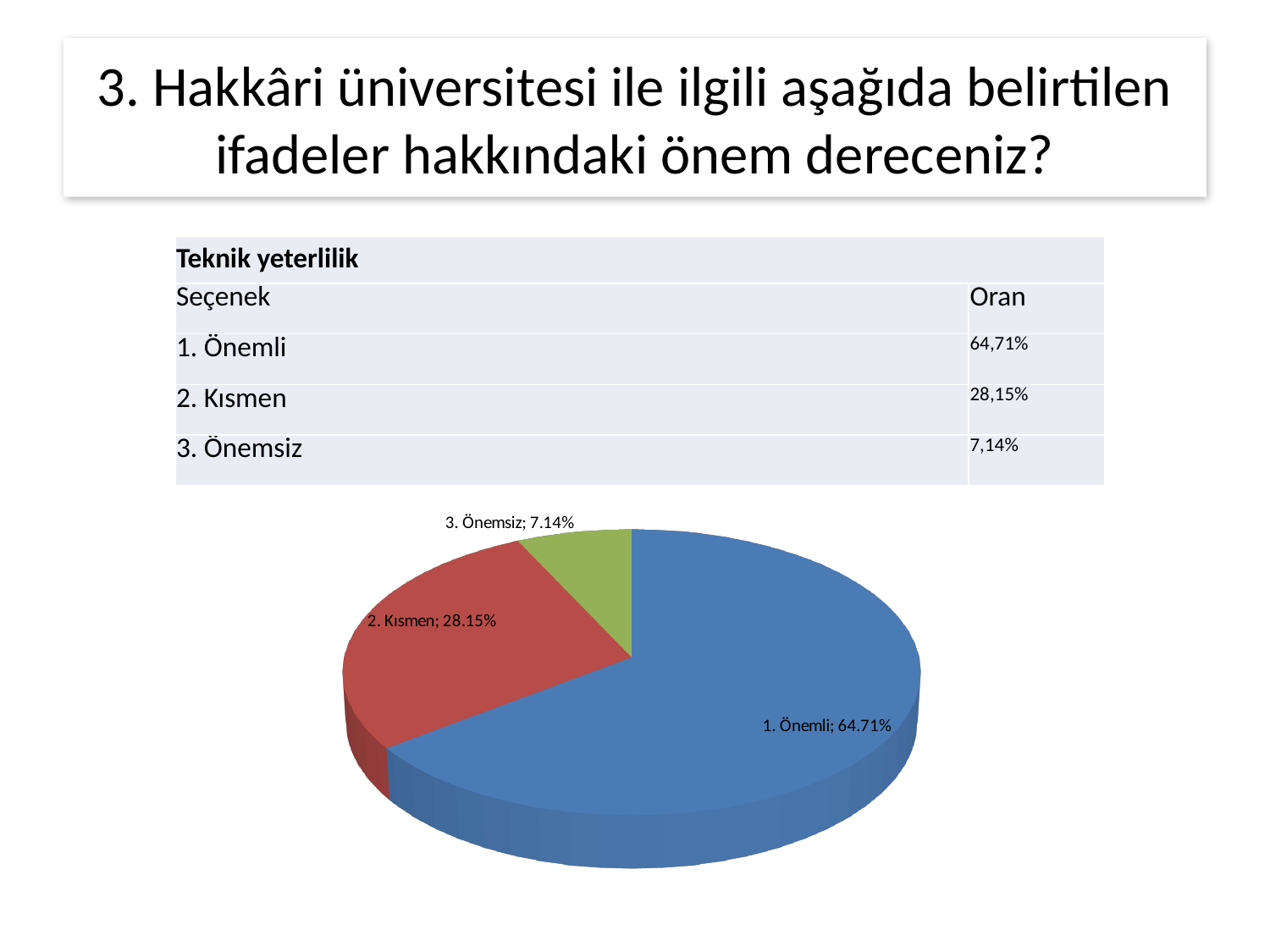
What is the value shown for the slice "1. Önemli" in the pie chart? 64.71% What is the value shown for the slice "3. Önemsiz" in the pie chart? 7.14% What kind of chart is shown on the slide? pie chart What is the difference between the values for "2. Kısmen" and "3. Önemsiz" in the pie chart? 21.01% What is the difference between the values for "1. Önemli" and "2. Kısmen" in the pie chart? 36.56% Which slice of the pie chart is the largest? 1. Önemli Which slice of the pie chart is the smallest? 3. Önemsiz What is the value shown for the slice "2. Kısmen" in the pie chart? 28.15% Which is larger in the pie chart, "2. Kısmen" or "3. Önemsiz"? 2. Kısmen What share of the pie does the "1. Önemli" slice represent? 64.71% How many slices does the pie chart have? 3 What colour is the "1. Önemli" slice in the pie chart? blue